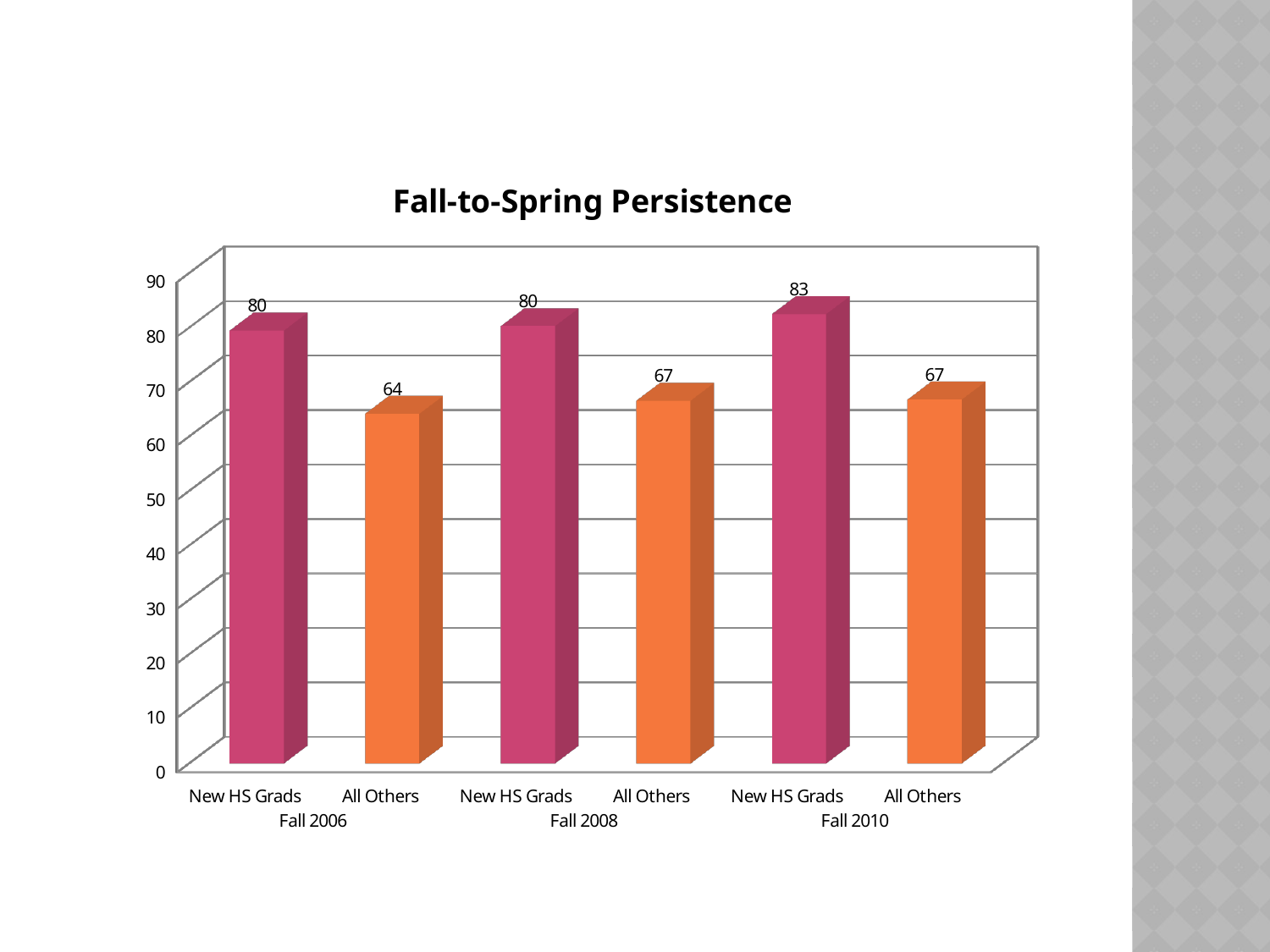
Which bar has the lowest value? All Others, Fall 2006 Which is larger, All Others in Fall 2006 or All Others in Fall 2008? All Others in Fall 2008 How many bars are plotted in the chart? 6 What is the title of the chart? Fall-to-Spring Persistence What is the difference between New HS Grads in Fall 2010 and New HS Grads in Fall 2006? 3 What is the difference between New HS Grads and All Others in Fall 2008? 13 Which bar has the highest value? New HS Grads, Fall 2010 What is the value for All Others in Fall 2010? 67 Is the value for New HS Grads in Fall 2010 greater or less than 70? greater What is the value for New HS Grads in Fall 2006? 80 What is the value for All Others in Fall 2006? 64 What kind of chart is shown? bar chart